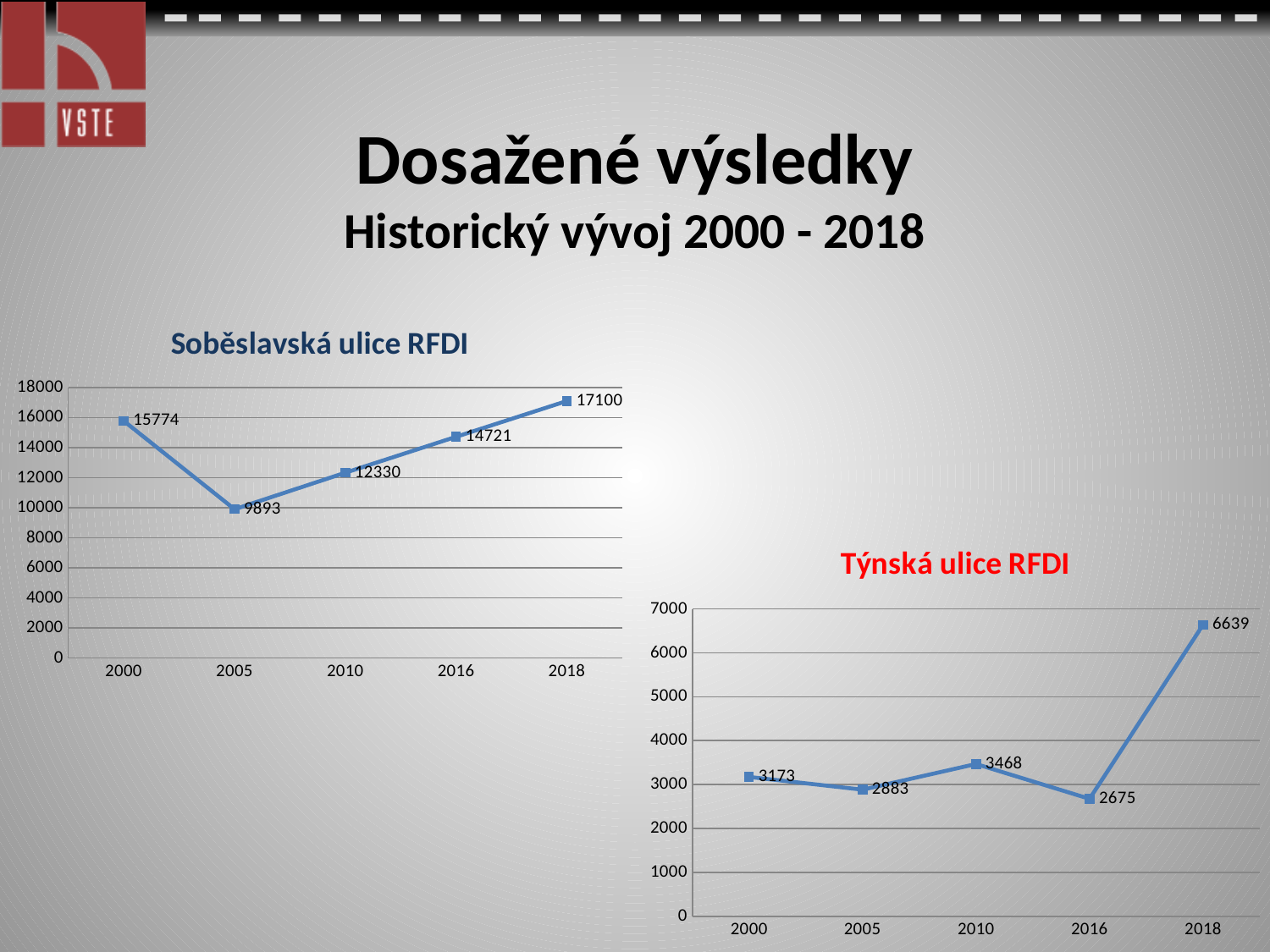
In the 'Týnská ulice RFDI' chart, what is the value for 2010? 3468 In the 'Týnská ulice RFDI' chart, what is the difference between the values for 2018 and 2016? 3964 In the 'Soběslavská ulice RFDI' chart, which year has the highest value? 2018 What kind of chart is the 'Týnská ulice RFDI' chart? line chart In the 'Soběslavská ulice RFDI' chart, which year has the lowest value? 2005 In the 'Týnská ulice RFDI' chart, which year has the highest value? 2018 In the 'Soběslavská ulice RFDI' chart, what is the difference between the values for 2018 and 2000? 1326 In the 'Týnská ulice RFDI' chart, which year has the lowest value? 2016 In the 'Týnská ulice RFDI' chart, which is larger, the value for 2000 or the value for 2005? 2000 In the 'Soběslavská ulice RFDI' chart, how many data points are plotted? 5 In the 'Soběslavská ulice RFDI' chart, what is the value for 2005? 9893 In the 'Soběslavská ulice RFDI' chart, do the values rise or fall from 2005 to 2018? rise